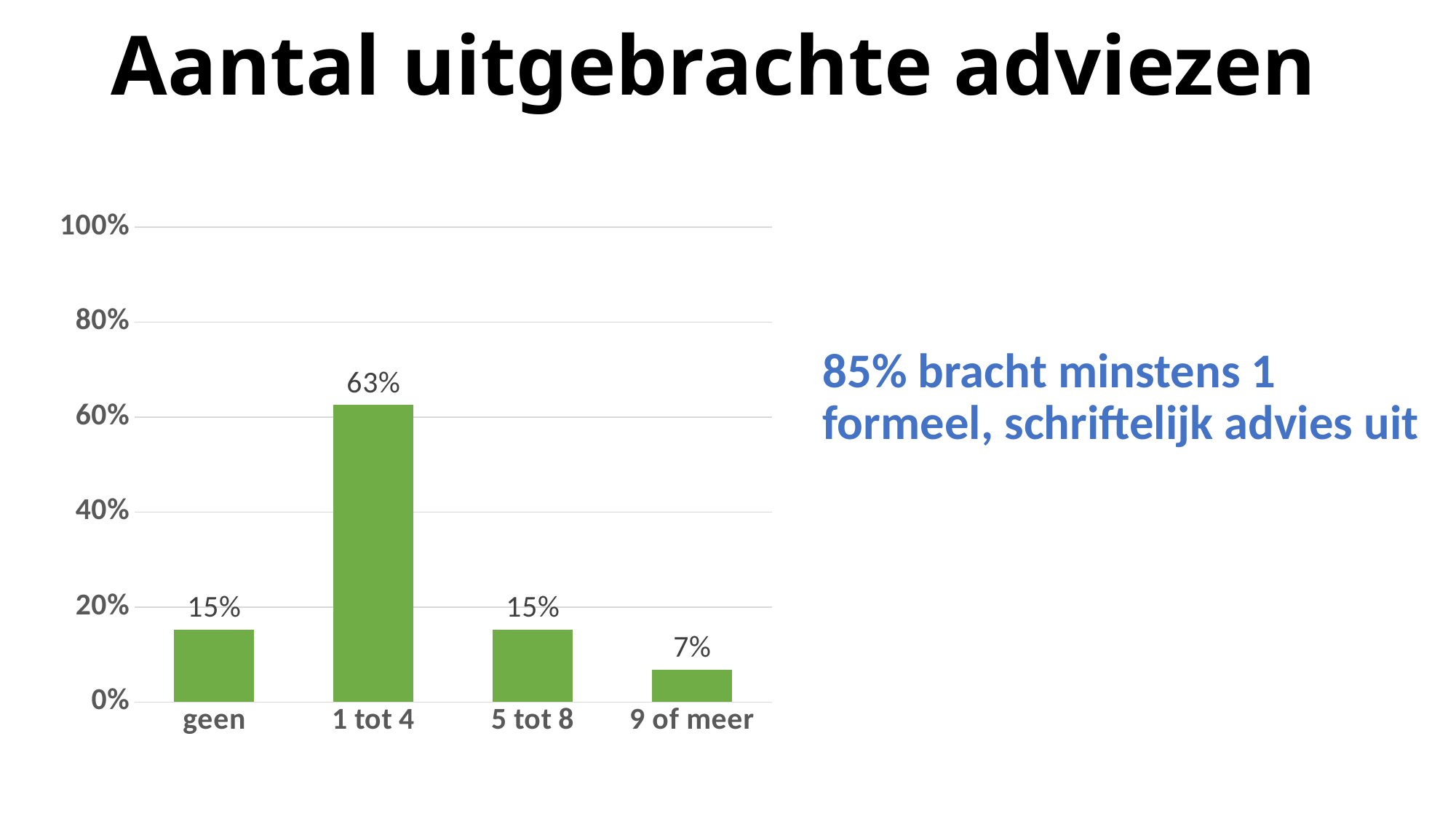
What is the difference between the values for '1 tot 4' and '5 tot 8'? 48% What is the value for the 'geen' category? 15% Is the value for '1 tot 4' greater or less than 60%? greater What kind of chart is shown on the slide? bar chart What is the title of the slide containing the chart? Aantal uitgebrachte adviezen What is the difference between the values for 'geen' and '9 of meer'? 8% Which category has the highest value? 1 tot 4 What is the value for the '9 of meer' category? 7% What is the value for the '1 tot 4' category? 63% Which category has the lowest value? 9 of meer Which is larger, the value for '1 tot 4' or the value for '9 of meer'? 1 tot 4 How many categories are shown on the x axis? 4